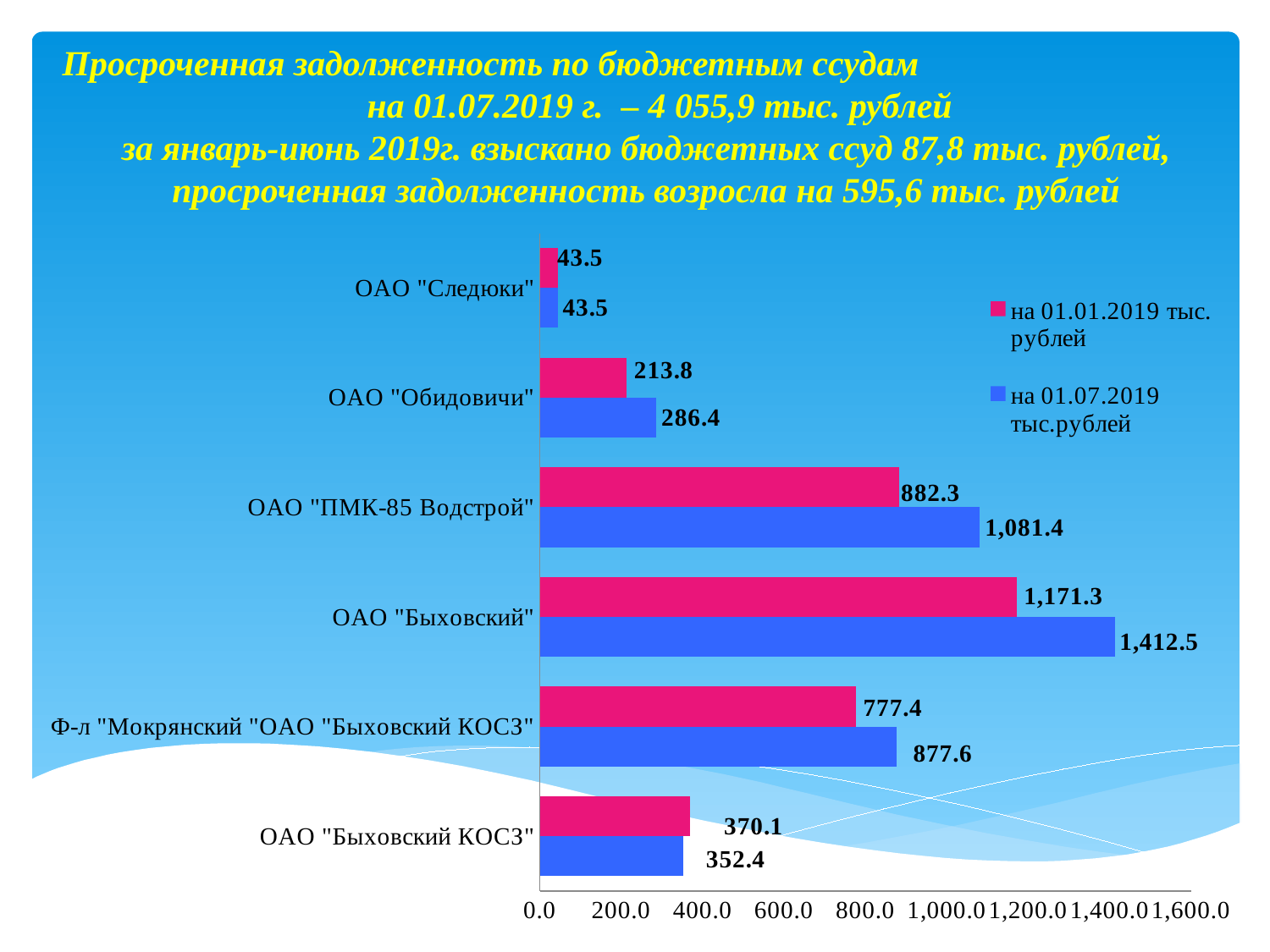
What is the value for ОАО "Быховский КОСЗ" in the series "на 01.07.2019 тыс.рублей"? 352.4 What is the difference between the "на 01.07.2019 тыс.рублей" and "на 01.01.2019 тыс. рублей" values for ОАО "Быховский"? 241.2 What is the value for ОАО "ПМК-85 Водстрой" in the series "на 01.01.2019 тыс. рублей"? 882.3 Is the value for ОАО "ПМК-85 Водстрой" in the series "на 01.07.2019 тыс.рублей" greater or less than 1,000.0? greater How many categories (organisations) are shown on the chart? 6 Which category has the highest value in the series "на 01.07.2019 тыс.рублей"? ОАО "Быховский" How many series does the legend list? 2 What colour are the bars for the series "на 01.01.2019 тыс. рублей"? pink What is the value for ОАО "Обидовичи" in the series "на 01.07.2019 тыс.рублей"? 286.4 Which category has the lowest value in the series "на 01.01.2019 тыс. рублей"? ОАО "Следюки" For Ф-л "Мокрянский "ОАО "Быховский КОСЗ", which series has the larger value: "на 01.01.2019 тыс. рублей" or "на 01.07.2019 тыс.рублей"? на 01.07.2019 тыс.рублей What type of chart is shown on the slide? bar chart